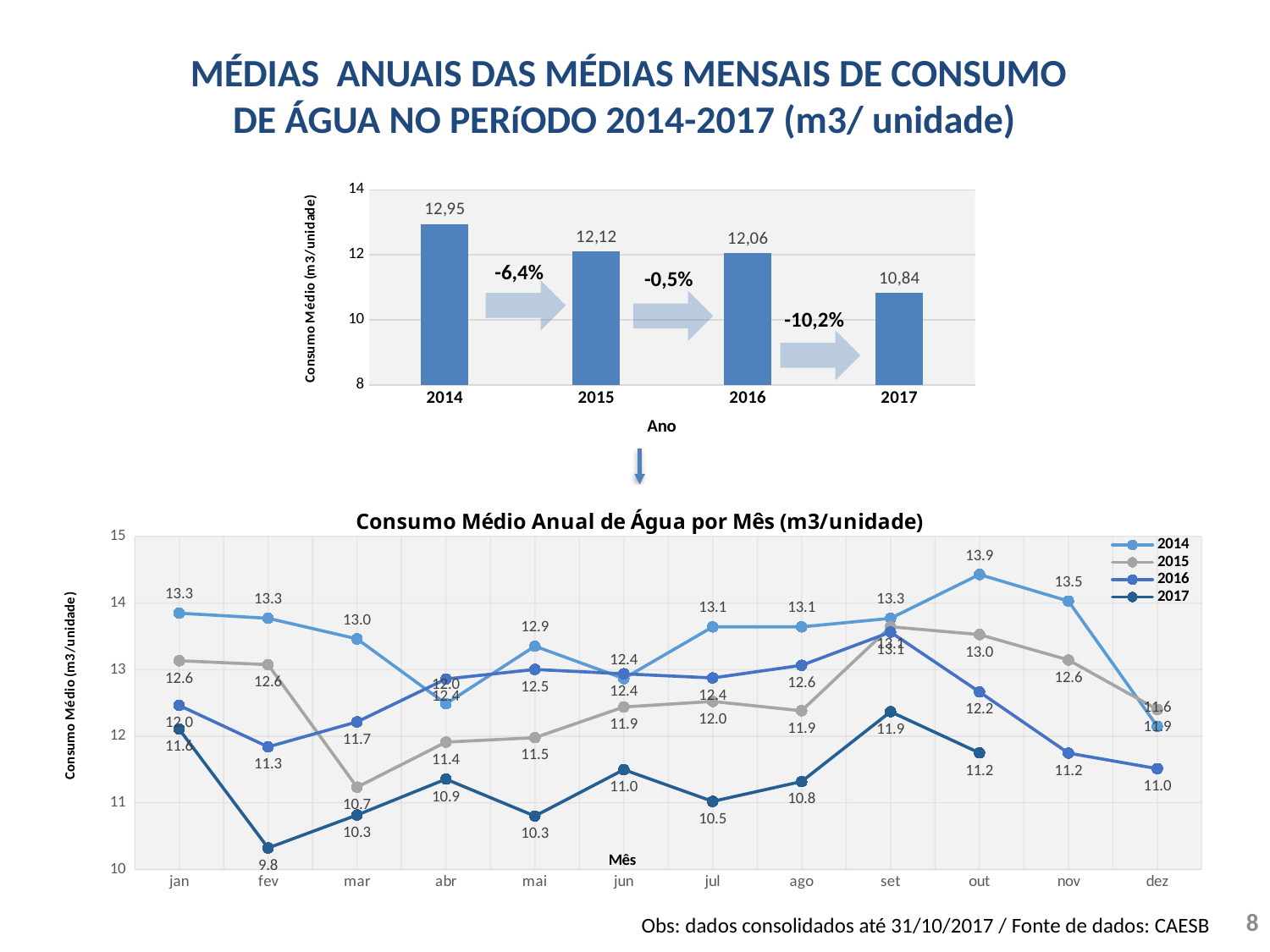
In the bottom chart 'Consumo Médio Anual de Água por Mês', how many series does the legend list? 4 In the top bar chart, what is the value for 2014? 12,95 In the top bar chart, which year has the lowest value? 2017 What kind of chart is the bottom chart, 'Consumo Médio Anual de Água por Mês (m3/unidade)'? line chart In the top bar chart, how many years are shown? 4 In the top bar chart, do the values rise or fall from 2014 to 2017? fall In the bottom chart 'Consumo Médio Anual de Água por Mês', what is the value for 2014 in out? 13.9 In the top bar chart, what is the difference between the values for 2014 and 2017? 2,11 In the bottom chart 'Consumo Médio Anual de Água por Mês', what is the value for 2017 in fev? 9.8 In the top bar chart, what is the value for 2017? 10,84 In the bottom chart 'Consumo Médio Anual de Água por Mês', which is larger in mar: the value for 2015 or the value for 2016? 2016 In the top bar chart, what percentage change is shown between 2016 and 2017? -10,2%